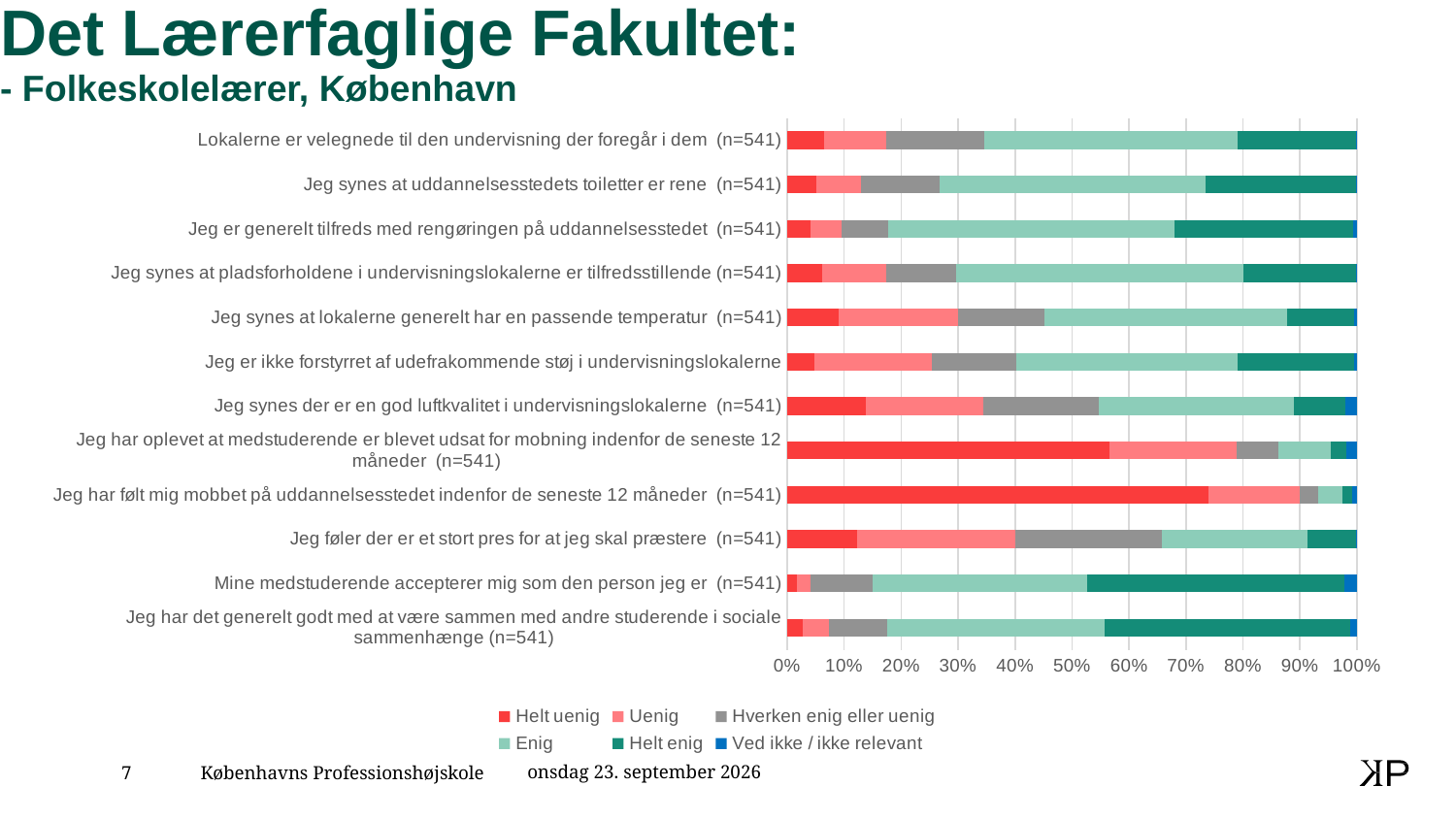
Is the 'Helt uenig' share for 'Jeg føler der er et stort pres for at jeg skal præstere' greater or less than 20%? less Which has the larger 'Helt uenig' share: 'Jeg synes der er en god luftkvalitet i undervisningslokalerne' or 'Jeg synes at lokalerne generelt har en passende temperatur'? Jeg synes der er en god luftkvalitet i undervisningslokalerne How many statements (categories) are plotted in the chart? 12 What kind of chart is shown on the slide? Stacked bar chart Is the 'Helt enig' share for 'Mine medstuderende accepterer mig som den person jeg er' greater or less than 30%? greater Is the 'Helt uenig' share for 'Jeg har oplevet at medstuderende er blevet udsat for mobning indenfor de seneste 12 måneder' greater or less than 50%? greater How many series does the legend list? 6 What is the highest value shown on the horizontal axis? 100% Which statement has the largest 'Helt uenig' share? Jeg har følt mig mobbet på uddannelsesstedet indenfor de seneste 12 måneder (n=541) Which has the larger 'Helt uenig' share: 'Jeg føler der er et stort pres for at jeg skal præstere' or 'Jeg synes at uddannelsesstedets toiletter er rene'? Jeg føler der er et stort pres for at jeg skal præstere Which legend entry is shown in blue? Ved ikke / ikke relevant